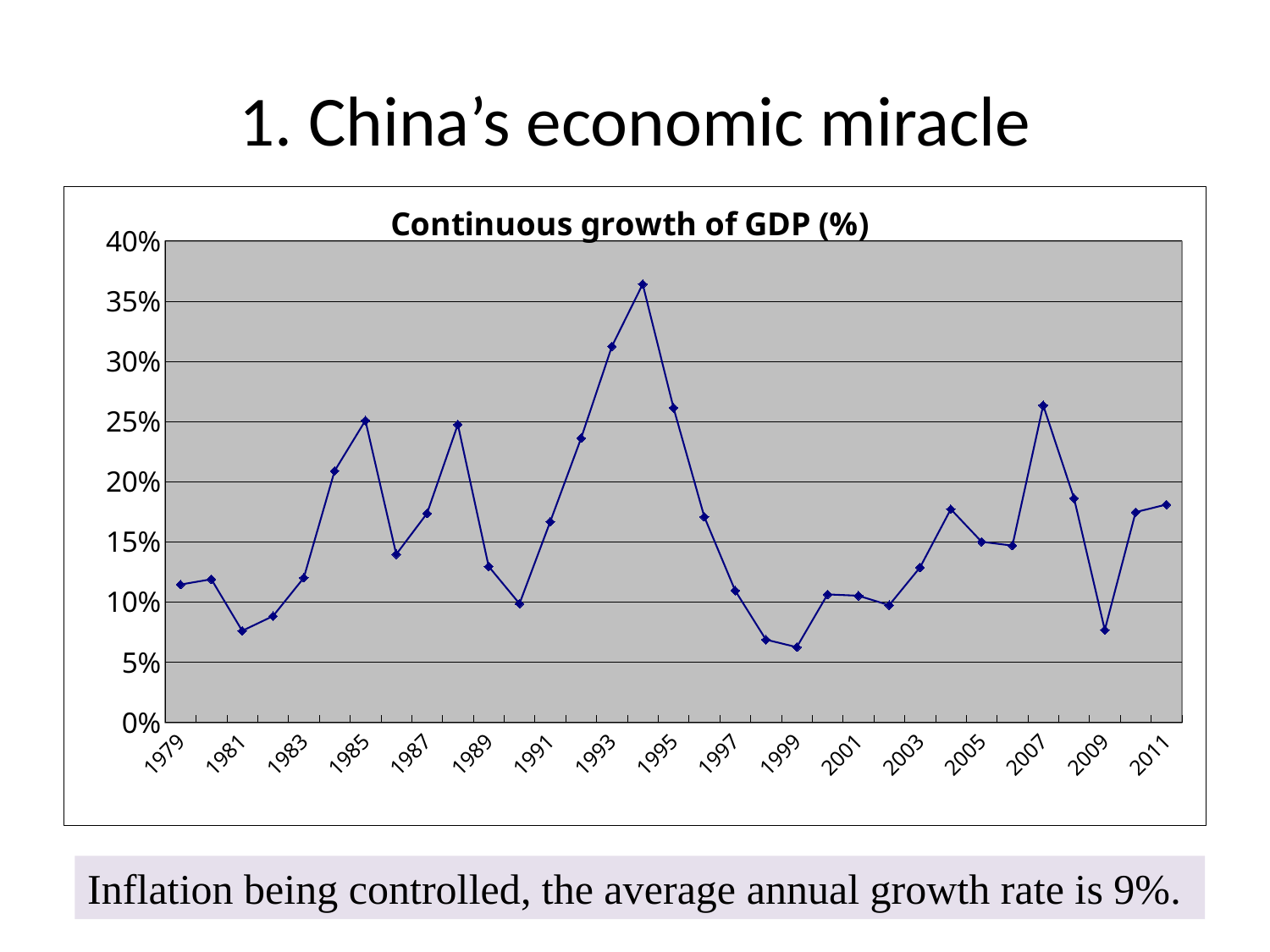
Which year has the higher value, 1985 or 1999? 1985 Is the value for 1981 greater or less than 10%? less What is the highest value shown on the vertical axis? 40% Is the value for 2007 greater or less than 25%? greater Do the values rise or fall from 1994 to 1999? fall In which year does the GDP growth line reach its highest point? 1994 Is the value for 1985 greater or less than 20%? greater What kind of chart is shown on the slide? line chart Which year has the higher value, 1994 or 2007? 1994 What is the title of the chart? Continuous growth of GDP (%)